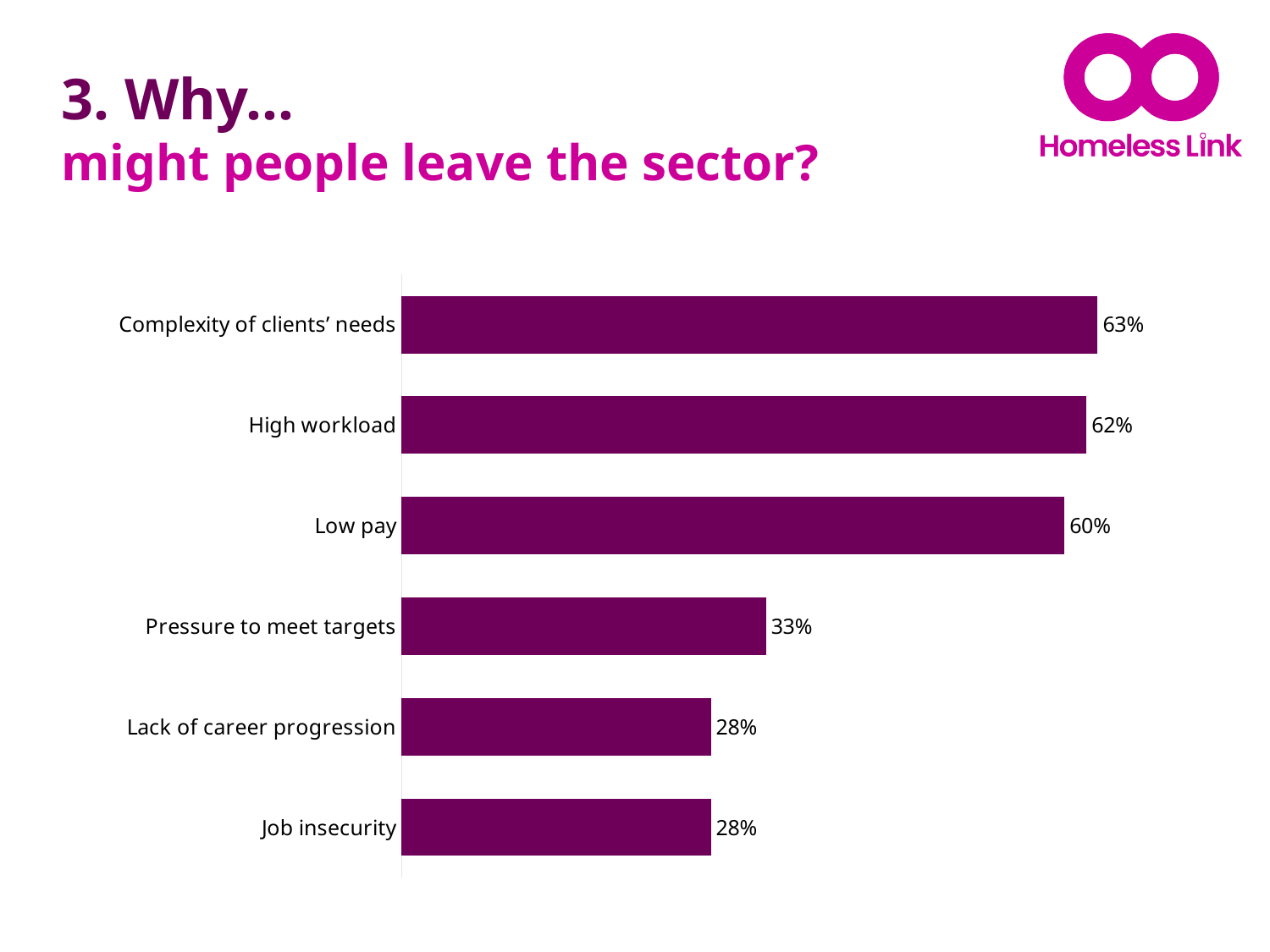
What is the difference between the values for Complexity of clients' needs and High workload? 1% What kind of chart is shown on the slide? Bar chart What colour are the bars in the chart? Purple What is the value for High workload? 62% What is the value for Lack of career progression? 28% What is the value for Pressure to meet targets? 33% Which category has the highest value? Complexity of clients' needs What is the value for Low pay? 60% What is the value for Complexity of clients' needs? 63% Which is larger, the value for High workload or the value for Lack of career progression? High workload How many categories are shown in the chart? 6 What is the difference between the values for Low pay and Pressure to meet targets? 27%